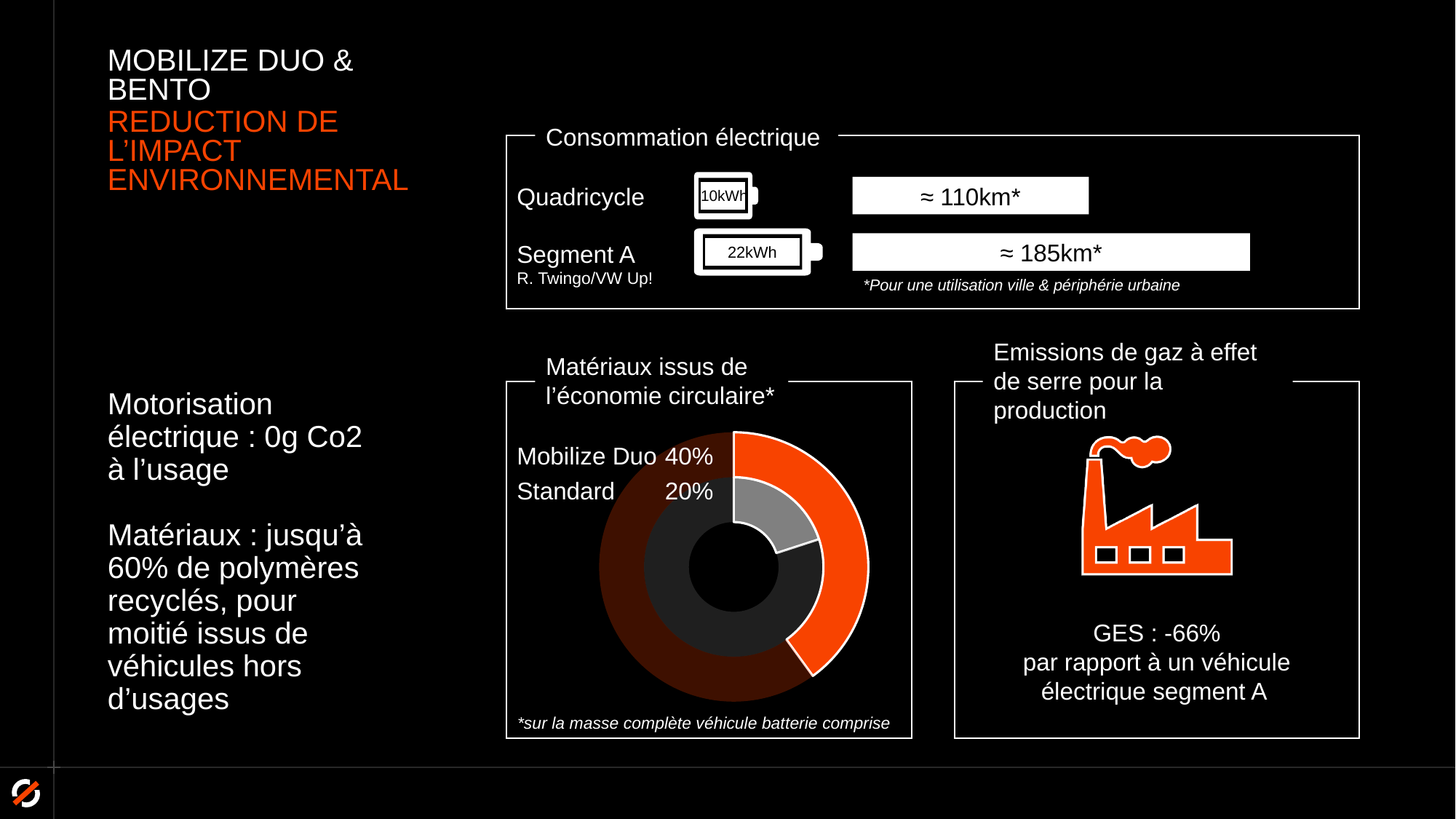
In the 'Matériaux issus de l'économie circulaire' chart, which category has the highest value? Mobilize Duo In the 'Matériaux issus de l'économie circulaire' chart, is the value for Standard greater or less than 30%? less In the 'Matériaux issus de l'économie circulaire' chart, what is the value for Mobilize Duo? 40% In the 'Matériaux issus de l'économie circulaire' chart, what is the value for Standard? 20% What footnote appears below the 'Matériaux issus de l'économie circulaire' chart? *sur la masse complète véhicule batterie comprise How many categories are shown in the 'Matériaux issus de l'économie circulaire' chart? 2 What kind of chart is the 'Matériaux issus de l'économie circulaire' chart? Donut (pie) chart In the 'Matériaux issus de l'économie circulaire' chart, what colour is the Mobilize Duo segment? Orange In the 'Matériaux issus de l'économie circulaire' chart, is the value for Mobilize Duo larger or smaller than the value for Standard? larger In the 'Matériaux issus de l'économie circulaire' chart, which category has the lowest value? Standard In the 'Matériaux issus de l'économie circulaire' chart, what is the difference between the Mobilize Duo value and the Standard value? 20%